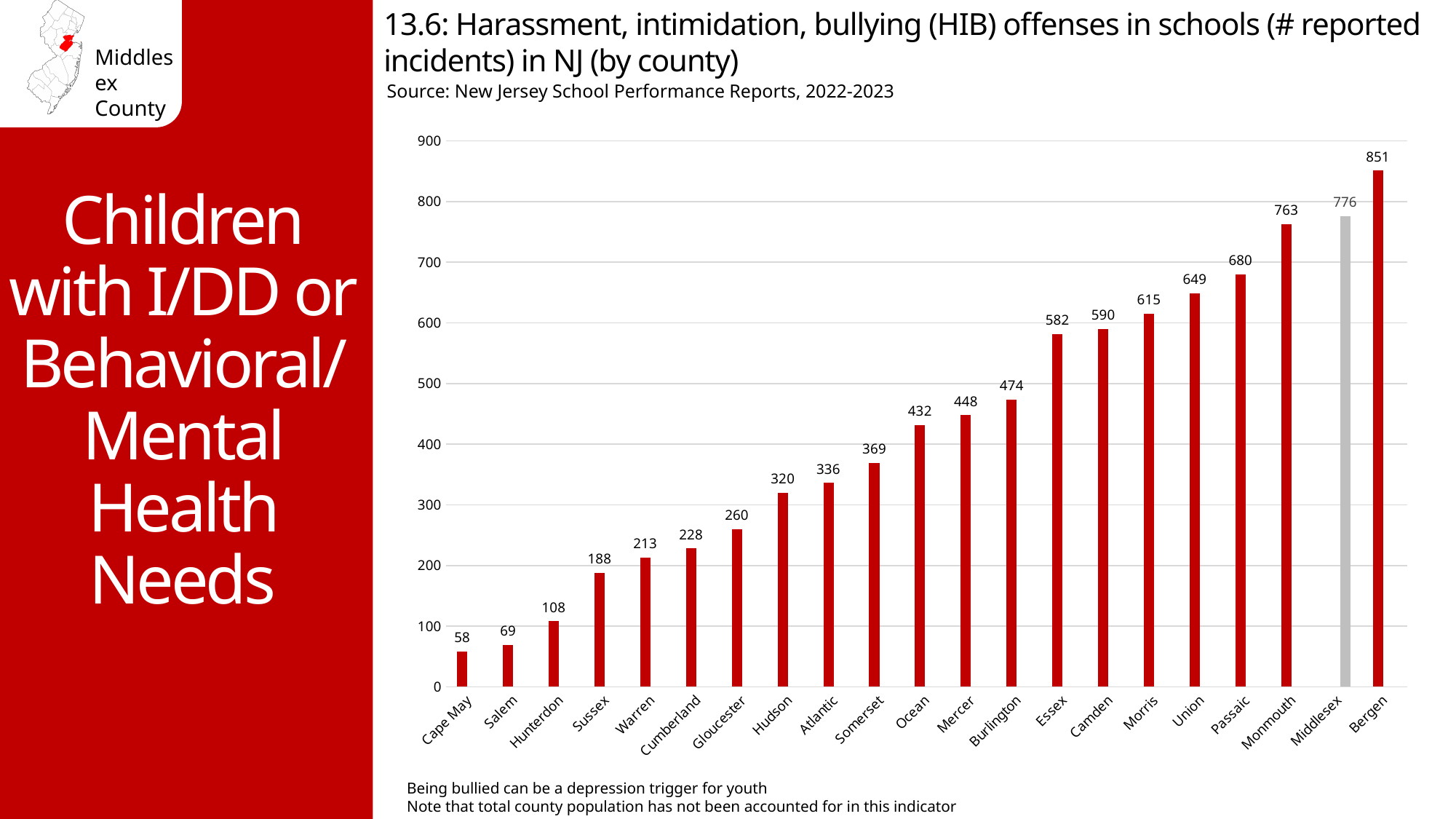
What is the difference between the values for Bergen and Middlesex? 75 Which has more reported HIB incidents, Essex or Camden? Camden Do the values rise or fall from left to right along the x axis? Rise Which county has the highest number of reported HIB incidents? Bergen Is the value for Monmouth greater or less than 700? greater Which county has the lowest number of reported HIB incidents? Cape May Which bar is shown in a different colour (grey) from the others? Middlesex What is the difference between the values for Salem and Cape May? 11 What is the number of reported HIB incidents for Middlesex? 776 What is the number of reported HIB incidents for Hudson? 320 What kind of chart is shown on the slide? Bar chart How many counties are shown on the chart? 21